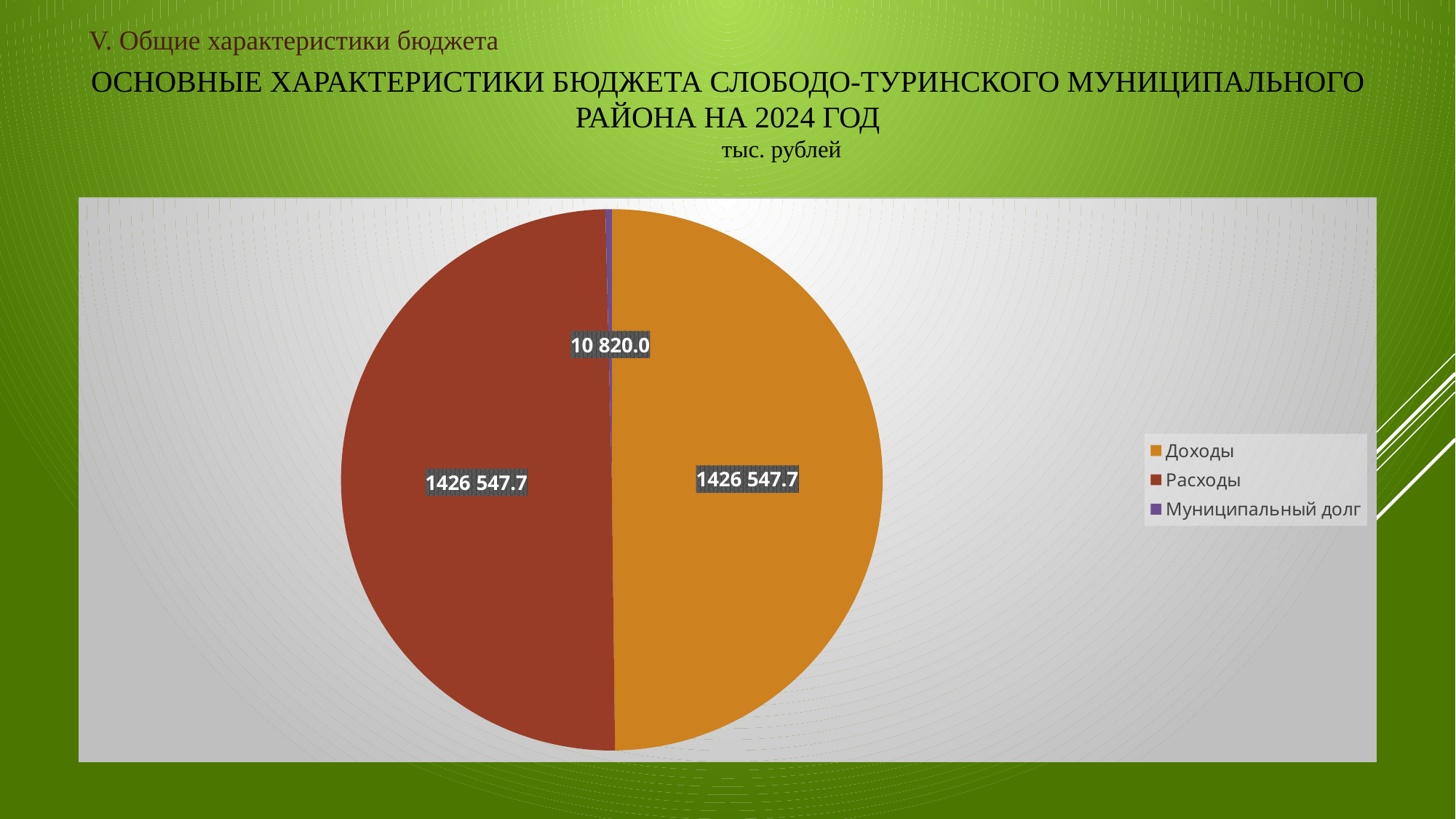
In what units are the chart values given, according to the slide? тыс. рублей What is the value for Расходы? 1426 547.7 How many entries does the legend list? 3 What is the value for Муниципальный долг? 10 820.0 How many slices does the pie chart have? 3 What is the value for Доходы? 1426 547.7 Are the values for Доходы and Расходы equal? Yes What is the difference between the values for Доходы and Муниципальный долг? 1415 727.7 Which is larger, Расходы or Муниципальный долг? Расходы What kind of chart is shown on the slide? pie chart Which category has the smallest slice in the pie chart? Муниципальный долг What colour is the Доходы slice in the pie chart? orange